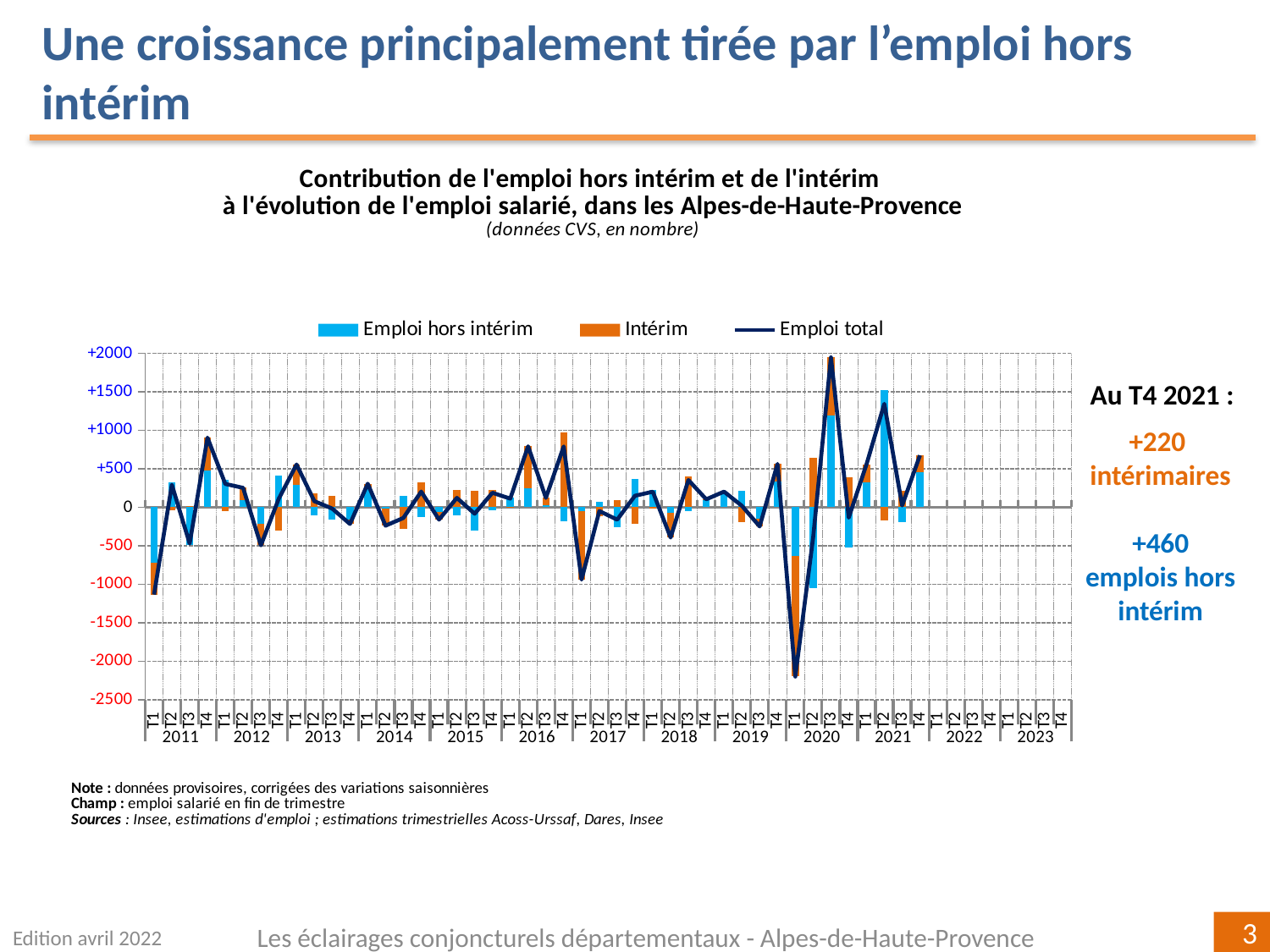
What are the three series listed in the legend? Emploi hors intérim, Intérim, Emploi total Is the value of Emploi total at T1 2020 greater or less than -2000? less What is the first year shown on the x axis? 2011 Is the value of Emploi total at T3 2020 greater or less than +1500? greater Which is larger, the Emploi total value at T3 2020 or at T2 2021? T3 2020 Is the value of Emploi hors intérim at T2 2021 greater or less than +1000? greater According to the annotation, what is the value for Emploi hors intérim at T4 2021? +460 How many series does the legend list? 3 What kind of chart is shown on the slide? A bar chart combined with a line In which quarter does the Emploi total line reach its lowest point? T1 2020 According to the annotation, what is the value for Intérim at T4 2021? +220 In which quarter does the Emploi total line reach its highest point? T3 2020